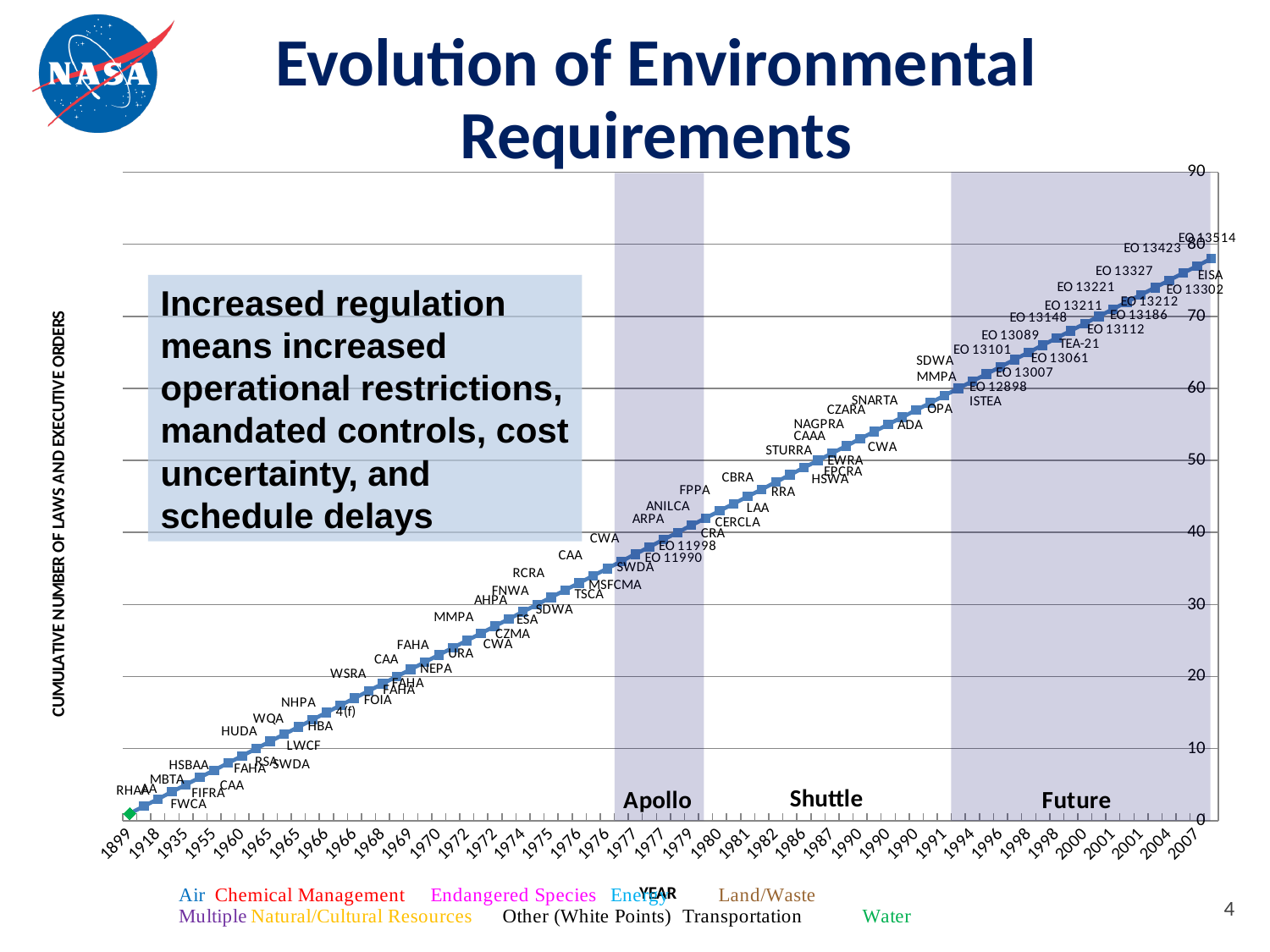
Is the cumulative number of laws and executive orders in 1970 greater or less than 20? greater What is the highest value shown on the y axis? 90 Which year on the x axis has the highest cumulative number of laws and executive orders? 2007 What kind of chart is shown on the slide? line chart Does the cumulative number of laws and executive orders rise or fall as the years increase along the x axis? rise Which year on the x axis has the lowest cumulative number of laws and executive orders? 1899 Is the cumulative number of laws and executive orders in 2007 greater or less than 70? greater What is the title of the y axis? CUMULATIVE NUMBER OF LAWS AND EXECUTIVE ORDERS Is the cumulative number of laws and executive orders in 1998 greater or less than 60? greater Is the cumulative number of laws and executive orders higher in 1990 or in 1965? 1990